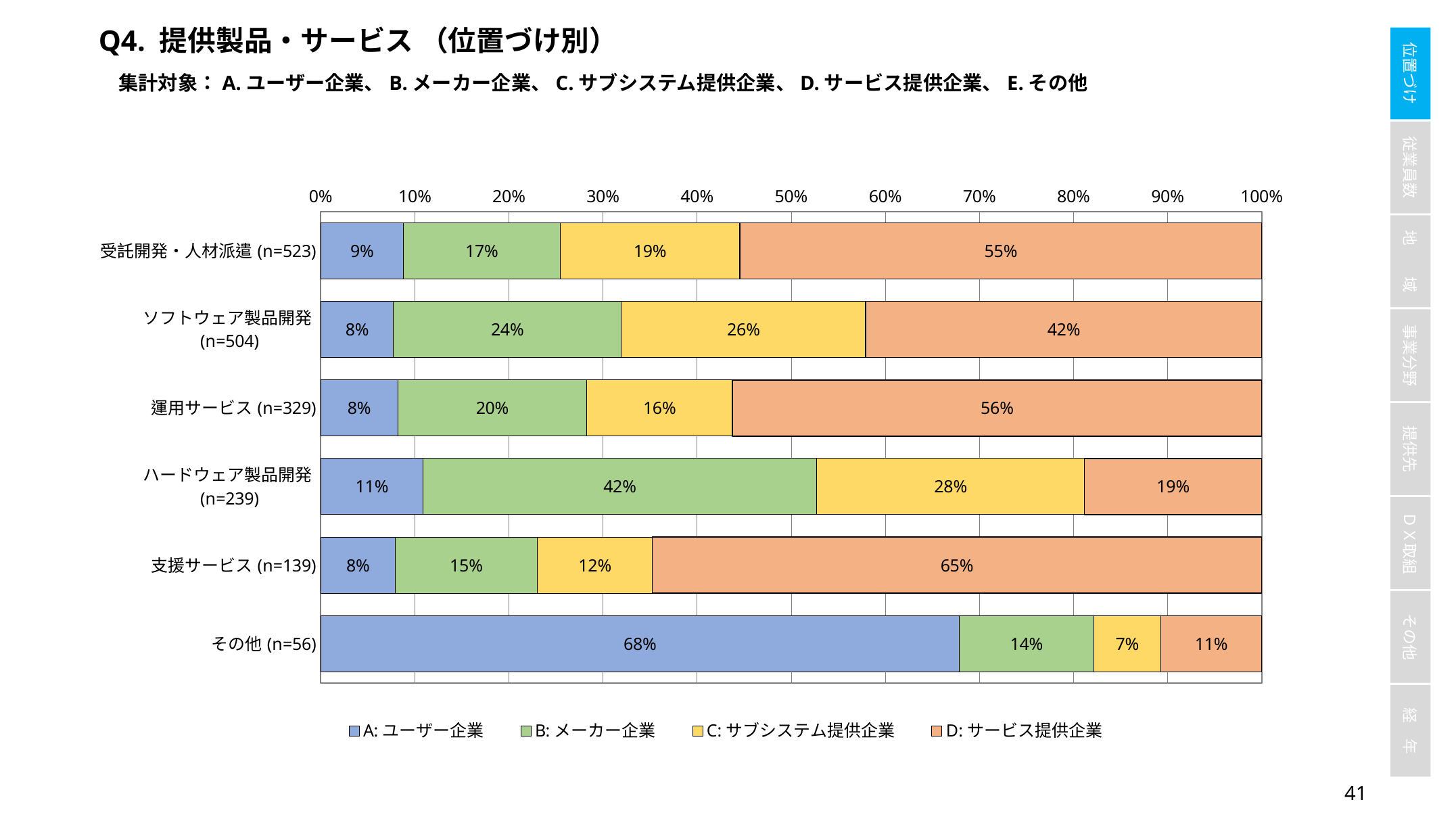
Which category has the highest value for D: サービス提供企業? 支援サービス (n=139) What kind of chart is shown on the slide? Stacked bar chart What is the value for D: サービス提供企業 in the 支援サービス (n=139) bar? 65% Which is larger: the B: メーカー企業 value for 受託開発・人材派遣 (n=523) or for 運用サービス (n=329)? 運用サービス (n=329) What colour represents A: ユーザー企業 in the chart? Blue How many series does the legend list? 4 What is the difference between the D: サービス提供企業 values for 運用サービス (n=329) and ソフトウェア製品開発 (n=504)? 14% How many categories (product/service types) are plotted on the chart? 6 Which category has the lowest value for C: サブシステム提供企業? その他 (n=56) What is the value for B: メーカー企業 in the ハードウェア製品開発 (n=239) bar? 42% What is the value for A: ユーザー企業 in the その他 (n=56) bar? 68% What is the value for C: サブシステム提供企業 in the ソフトウェア製品開発 (n=504) bar? 26%